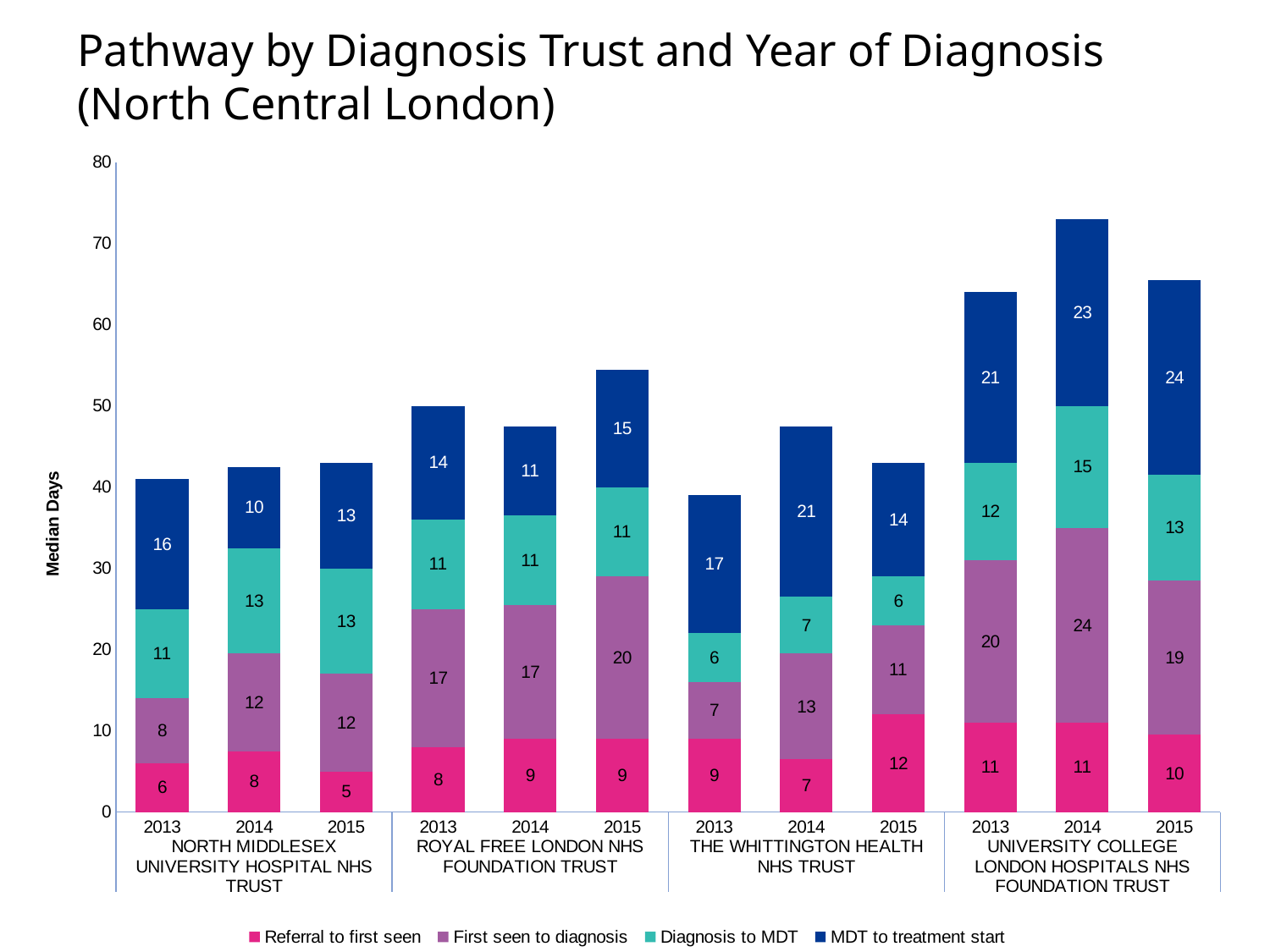
How many series does the legend list? 4 What is the difference in 'MDT to treatment start' median days between The Whittington Health NHS Trust in 2014 and 2015? 7 What is the median days for 'First seen to diagnosis' at Royal Free London NHS Foundation Trust in 2015? 20 What is the total median days for the University College London Hospitals NHS Foundation Trust 2014 bar? 73 What type of chart is shown on the slide? Stacked bar chart What is the median days for 'Referral to first seen' at North Middlesex University Hospital NHS Trust in 2015? 5 How many bars are plotted in the chart? 12 Which is larger: 'First seen to diagnosis' at University College London Hospitals NHS Foundation Trust in 2014 or at Royal Free London NHS Foundation Trust in 2014? University College London Hospitals NHS Foundation Trust in 2014 Which trust and year has the shortest stacked bar? The Whittington Health NHS Trust, 2013 Which trust and year has the tallest stacked bar? University College London Hospitals NHS Foundation Trust, 2014 What is the total median days for The Whittington Health NHS Trust 2013 bar? 39 What is the median days for 'MDT to treatment start' at University College London Hospitals NHS Foundation Trust in 2015? 24